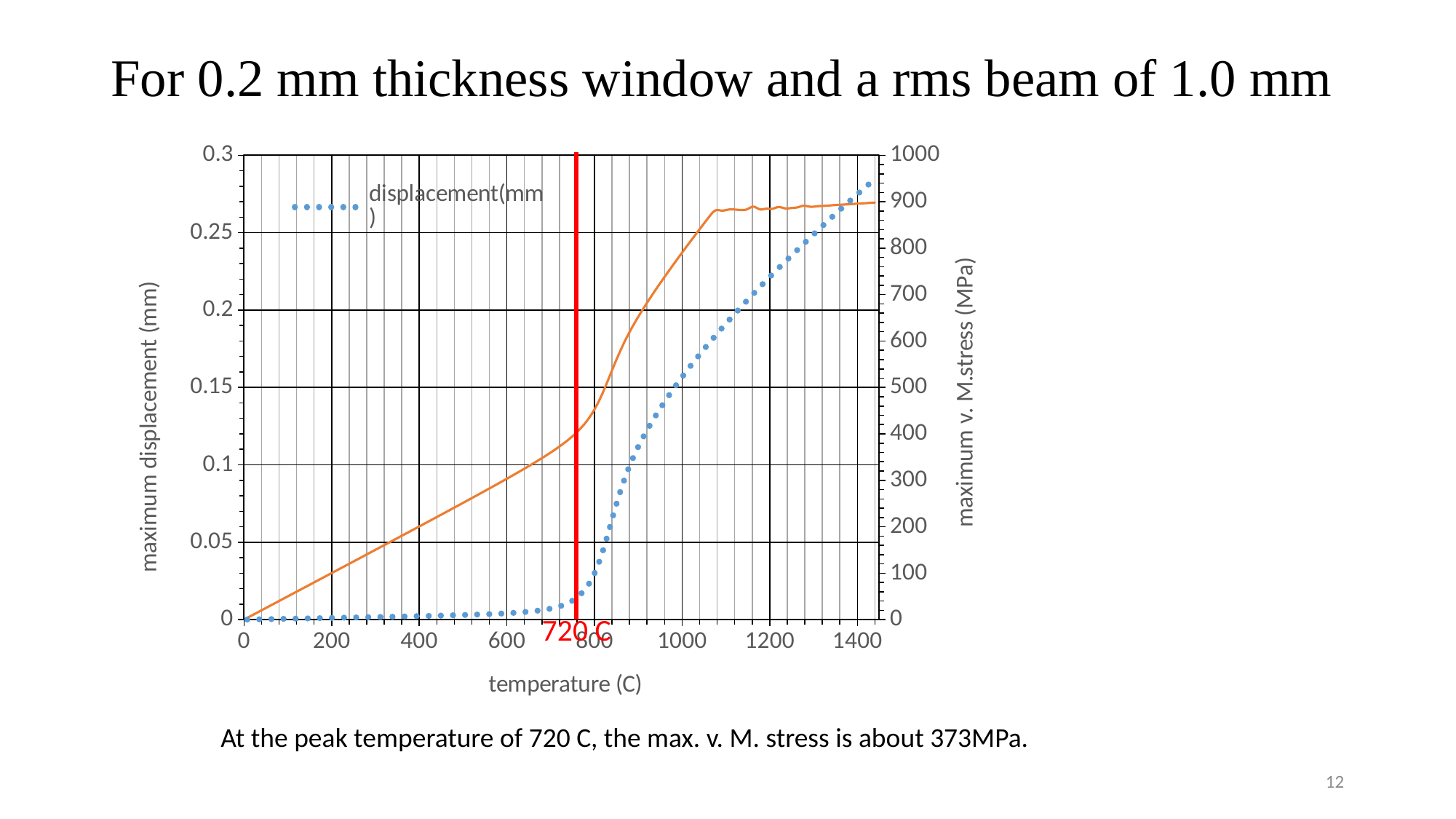
Is the stress value at 400 C greater or less than 300? less Is the stress value at 1200 C greater or less than 800? greater Which temperature is marked by the red vertical line on the chart? 720 C Is the displacement value at 600 C greater or less than 0.05? less Does the displacement series rise or fall as temperature increases from 0 to 1400 C? rise What is the title of the x axis of the chart? temperature (C) What kind of chart is shown on the slide? line chart According to the slide, what is the maximum v. M. stress at the peak temperature of 720 C? 373MPa What is the title of the right-hand y axis of the chart? maximum v. M.stress (MPa) How many series does the chart's legend list? 1